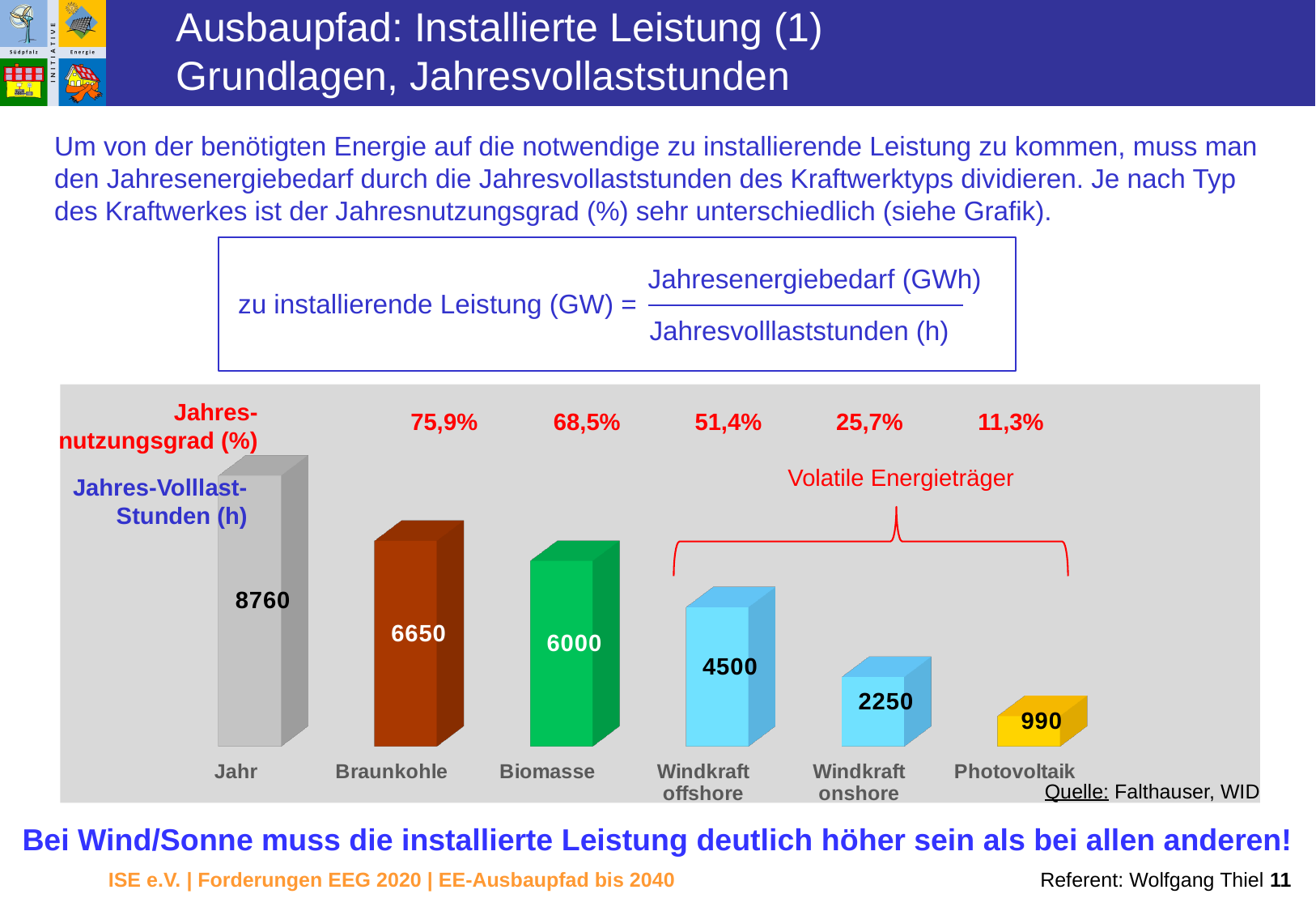
What is the difference in Jahres-Volllast-Stunden between Braunkohle and Biomasse? 650 What Jahresnutzungsgrad (%) is shown above the Biomasse bar? 68,5% What is the Jahres-Volllast-Stunden value shown for Braunkohle? 6650 Which category has the highest Jahres-Volllast-Stunden value? Jahr What kind of chart is shown on the slide? Bar chart How many categories (bars) are shown in the chart? 6 Which category has the lowest Jahres-Volllast-Stunden value? Photovoltaik Which has more Jahres-Volllast-Stunden, Biomasse or Windkraft offshore? Biomasse What is the Jahres-Volllast-Stunden value shown for Windkraft offshore? 4500 What Jahresnutzungsgrad (%) is shown above the Windkraft onshore bar? 25,7% What is the Jahres-Volllast-Stunden value shown for Photovoltaik? 990 What is the difference in Jahres-Volllast-Stunden between Windkraft offshore and Windkraft onshore? 2250